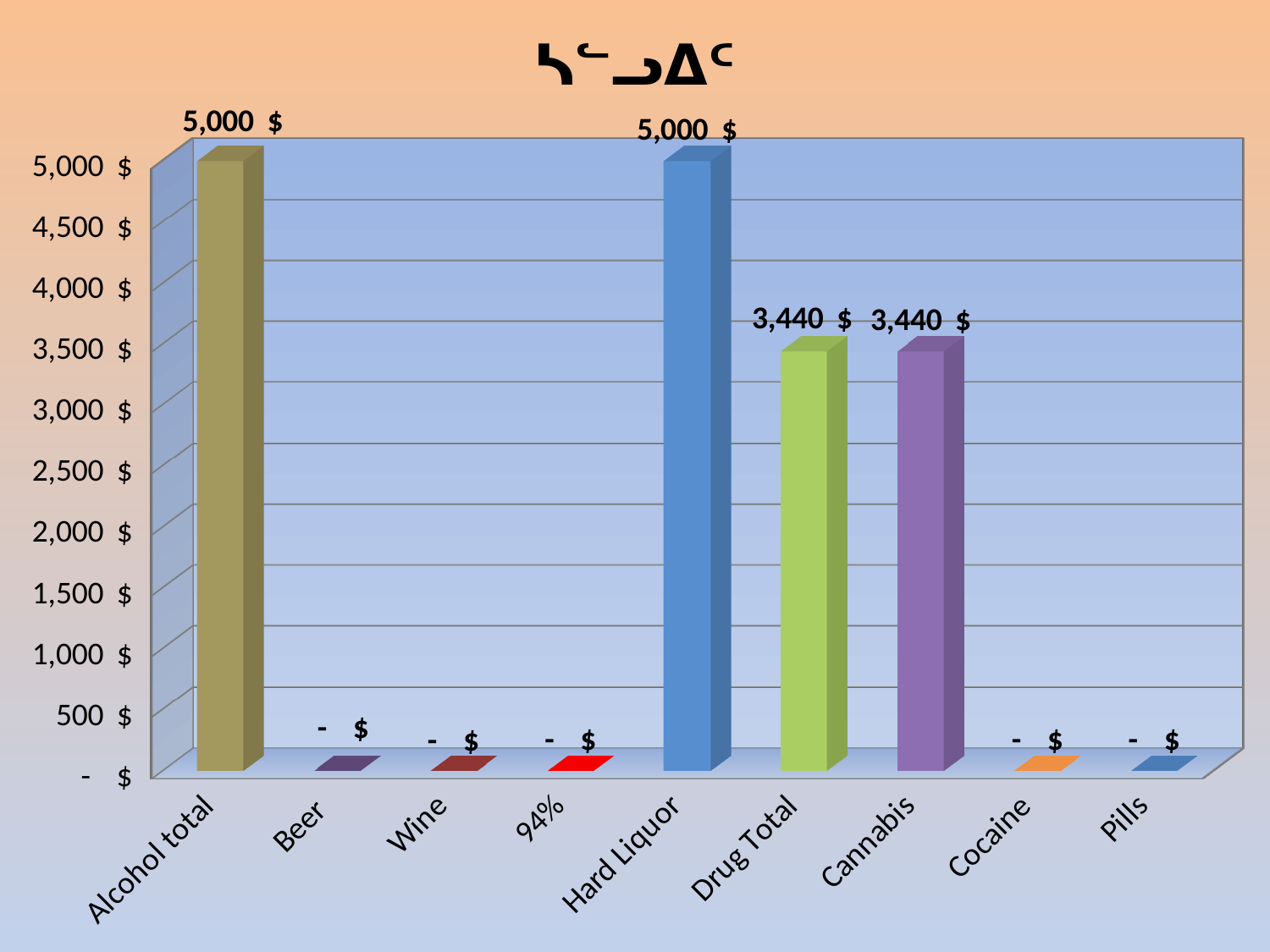
How many categories are shown on the x axis? 9 What is the value for Drug Total? 3,440 $ Which is larger, the value for Hard Liquor or the value for Cannabis? Hard Liquor What colour is the bar for Hard Liquor? blue What is the value for Cannabis? 3,440 $ What is the value shown for Cocaine? - $ What is the value for Alcohol total? 5,000 $ Is the value for Drug Total greater or less than 3,000 $? greater What is the difference between the values for Alcohol total and Drug Total? 1,560 $ What kind of chart is shown on the slide? bar chart What is the difference between the values for Hard Liquor and Cannabis? 1,560 $ What is the value for Hard Liquor? 5,000 $